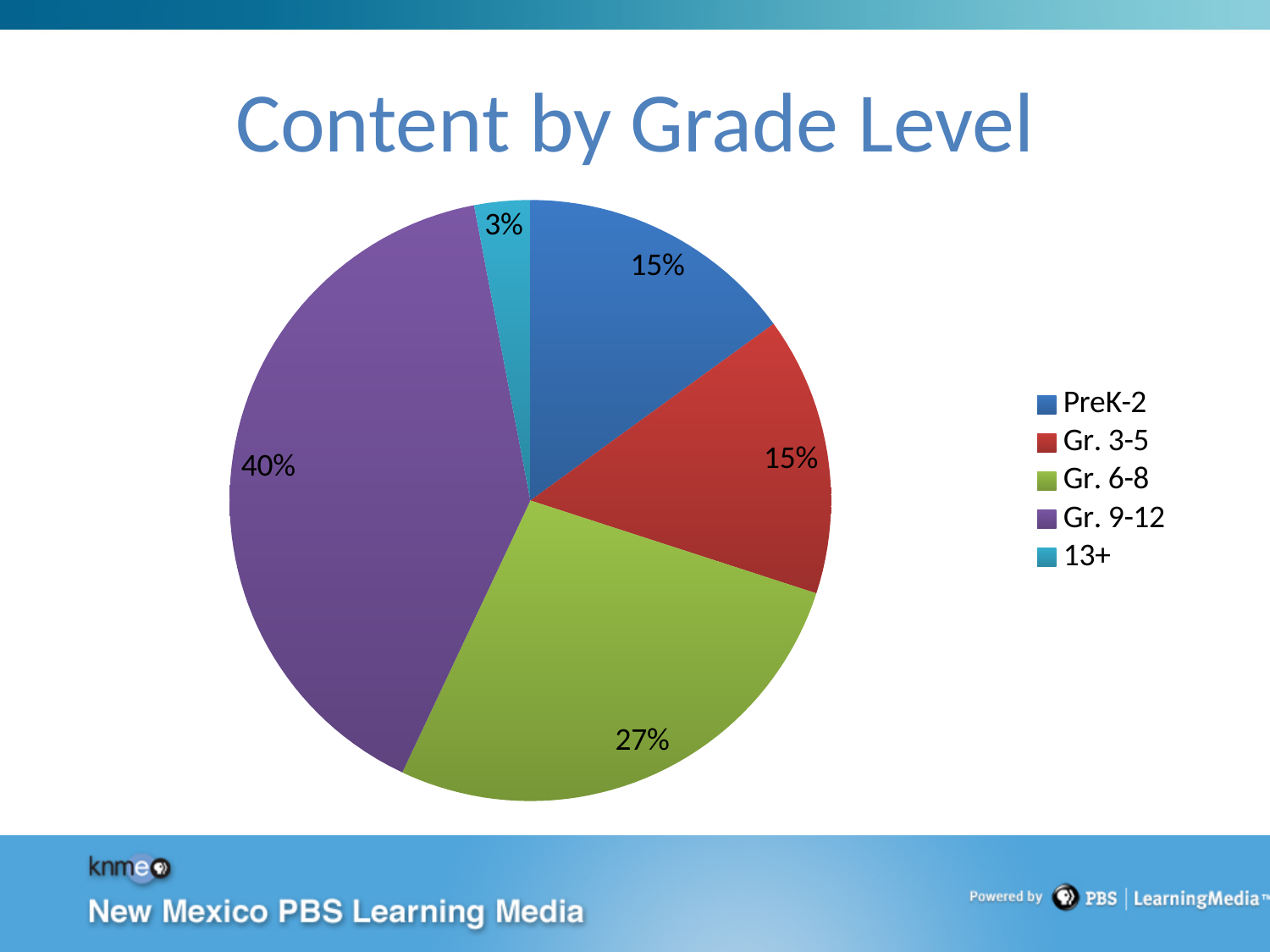
What share of content is for Gr. 6-8? 27% Which has a larger share of content, Gr. 6-8 or Gr. 3-5? Gr. 6-8 How many grade-level categories does the pie chart show? 5 Which grade level has the smallest share of content? 13+ Which grade level has the largest share of content? Gr. 9-12 What colour is the Gr. 9-12 slice? Purple What kind of chart is shown on the slide? Pie chart What is the title of the chart? Content by Grade Level What share of content is for PreK-2? 15% What share of content is for 13+? 3% What is the difference in percentage points between the Gr. 9-12 share and the Gr. 6-8 share? 13